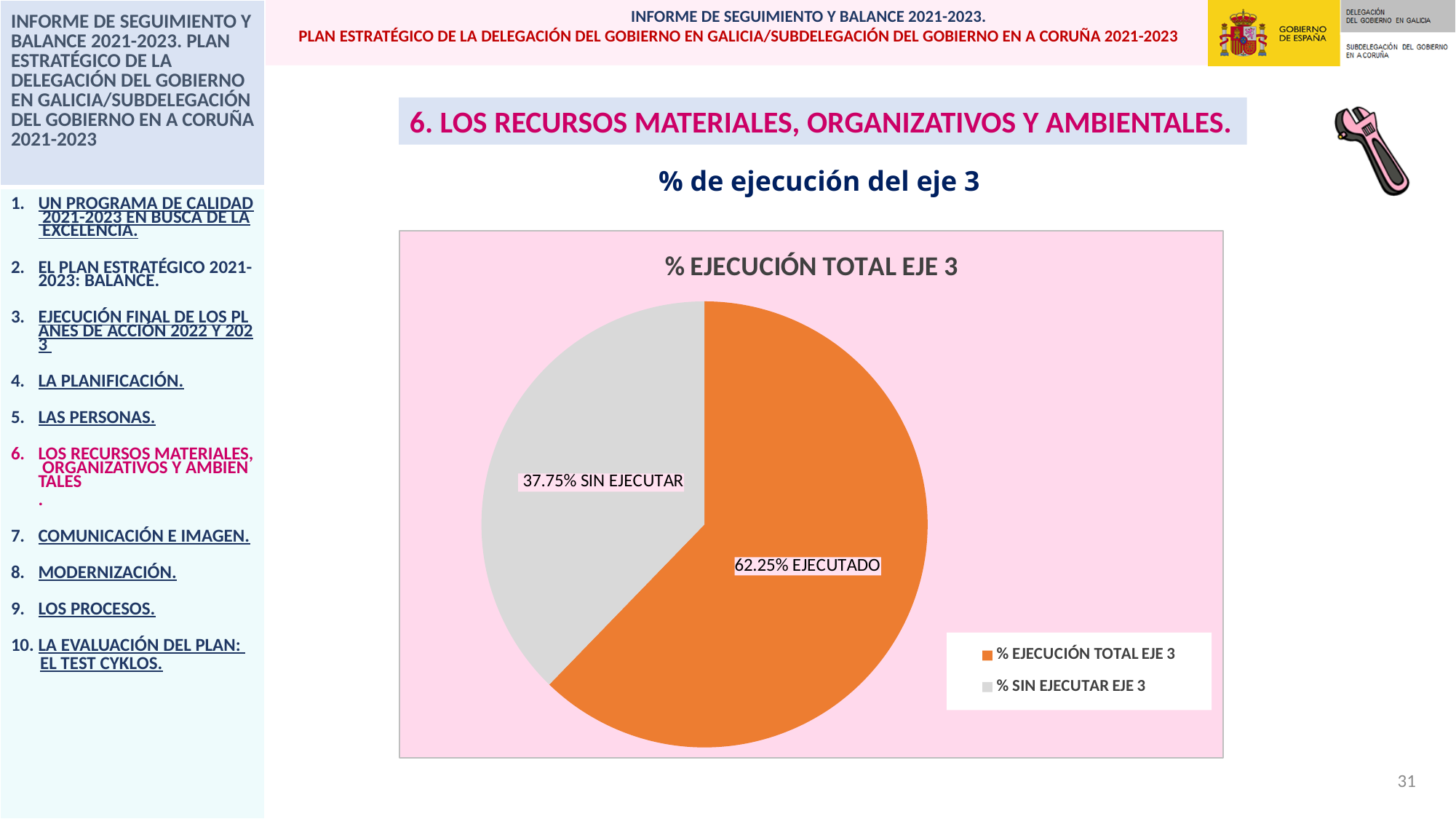
What is the difference between the EJECUTADO share and the SIN EJECUTAR share? 24.50% What is the title of the chart? % EJECUCIÓN TOTAL EJE 3 What percentage of eje 3 is shown as SIN EJECUTAR? 37.75% Which slice of the pie is the smallest? % SIN EJECUTAR EJE 3 How many entries does the legend list? 2 How many slices does the pie chart have? 2 What colour is the % SIN EJECUTAR EJE 3 slice? grey What type of chart is shown on the slide? pie chart What is the total of the two slices shown in the pie chart? 100% Which slice of the pie is the largest? % EJECUCIÓN TOTAL EJE 3 Which is larger, the EJECUTADO share or the SIN EJECUTAR share? EJECUTADO What percentage of eje 3 is shown as EJECUTADO? 62.25%